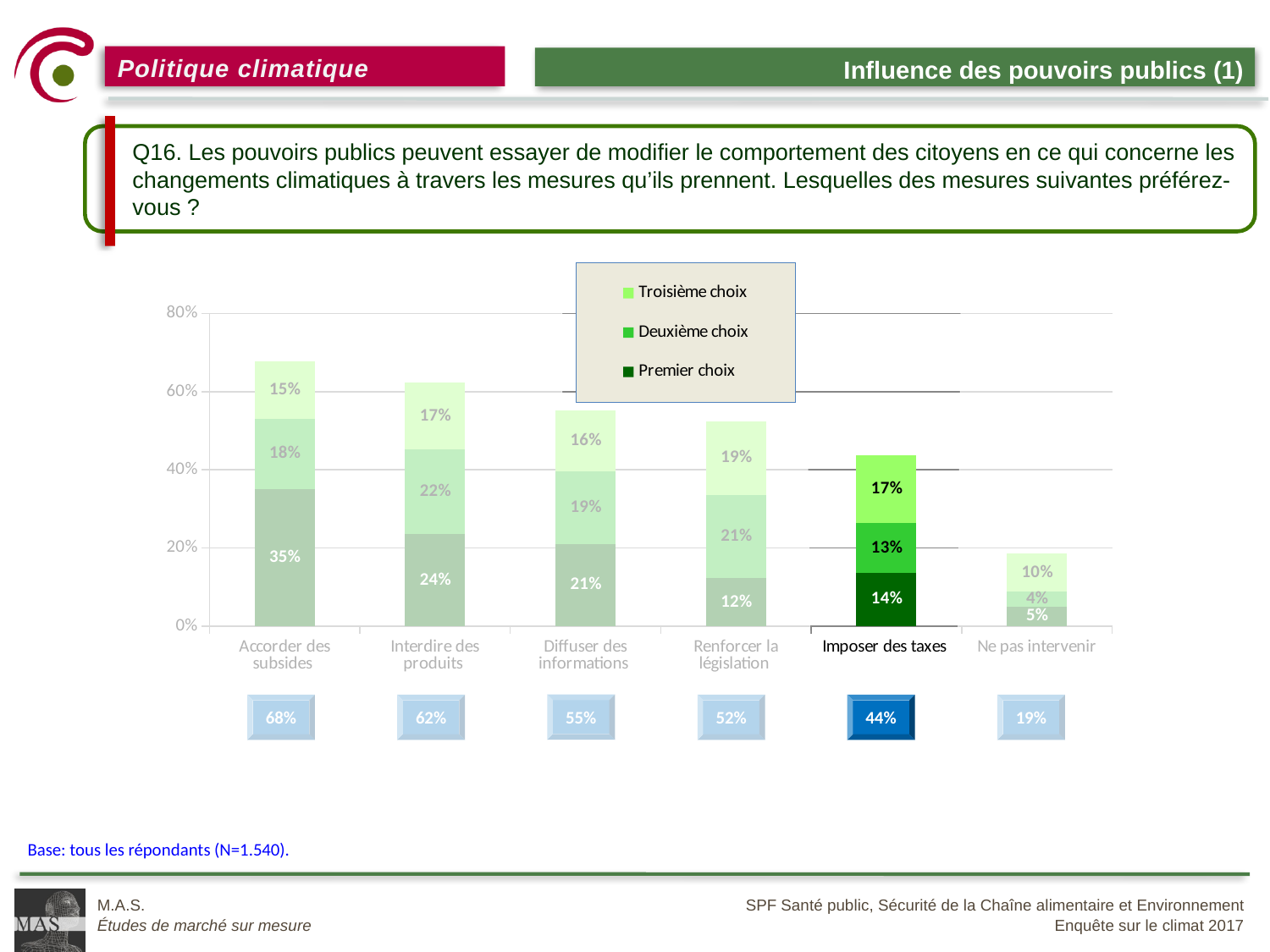
What is the Deuxième choix value for Imposer des taxes? 13% Which legend entry is shown in the darkest green? Premier choix Which is larger: the Premier choix value for Diffuser des informations or for Imposer des taxes? Diffuser des informations What is the Troisième choix value for Renforcer la législation? 19% What is the Premier choix value for Accorder des subsides? 35% How many series does the legend list? 3 Which category has the highest total stacked bar? Accorder des subsides Which category has the lowest total stacked bar? Ne pas intervenir What is the difference between the Premier choix values for Interdire des produits and Renforcer la législation? 12% How many categories are shown on the x axis? 6 What is the total of the stacked bar for Diffuser des informations? 55% What kind of chart is shown on the slide? stacked bar chart